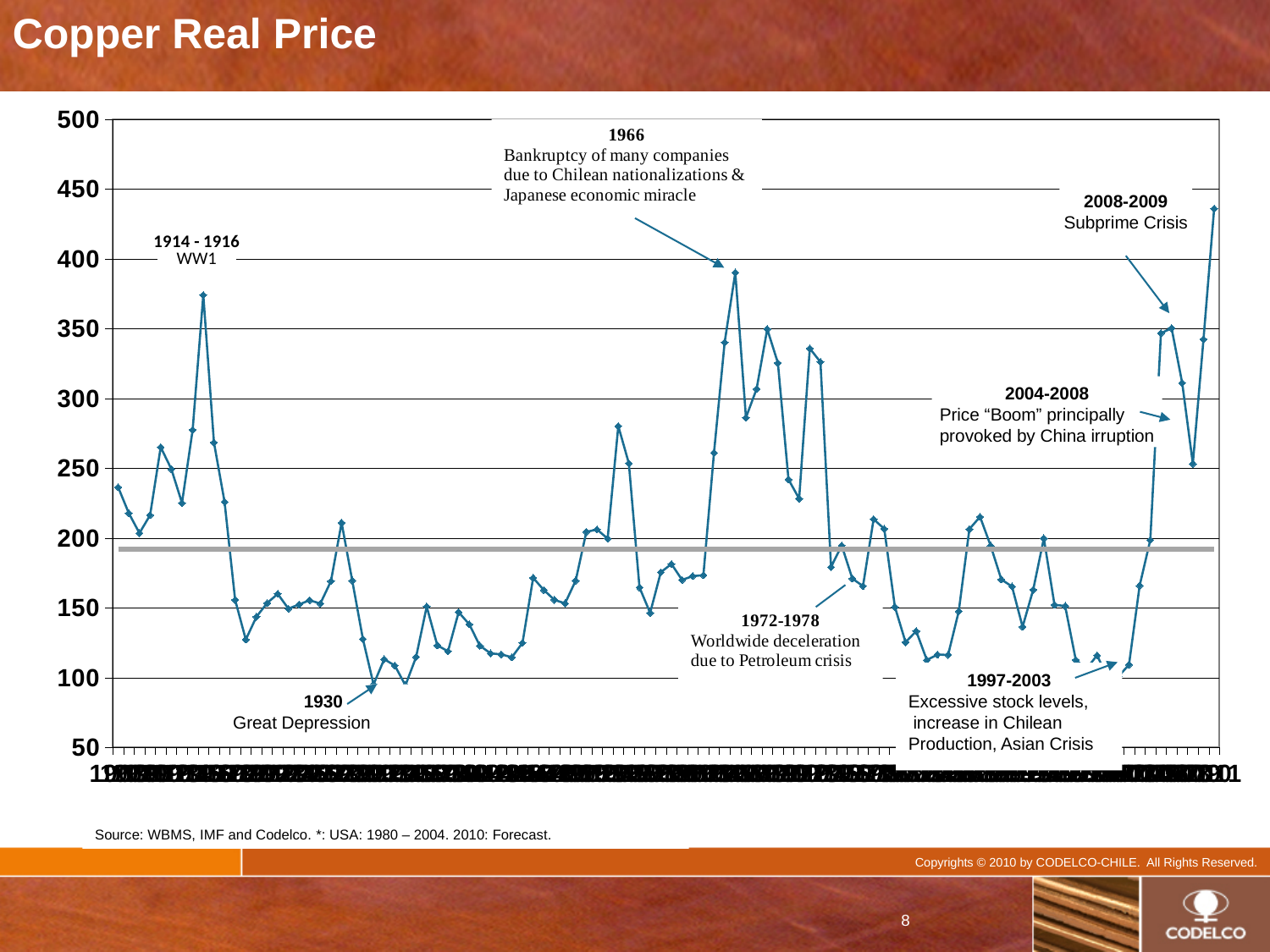
Is the value at the point marked for the 2008-2009 Subprime Crisis greater or less than 300? greater Is the value at the 1914-1916 WW1 peak greater or less than 350? greater Which is higher: the final point of the series or the 1966 peak? the final point Does the series rise or fall between the 1997-2003 low and the 2008-2009 Subprime Crisis point? rise Is the value at the 1966 peak (Bankruptcy of many companies) greater or less than 350? greater Which is higher: the 1966 peak or the 1914-1916 WW1 peak? 1966 peak What is the highest value shown on the y axis? 500 What kind of chart is shown on the slide? line chart What event does the annotation for 1972-1978 attribute the worldwide deceleration to? Petroleum crisis What is the title of the slide's chart? Copper Real Price